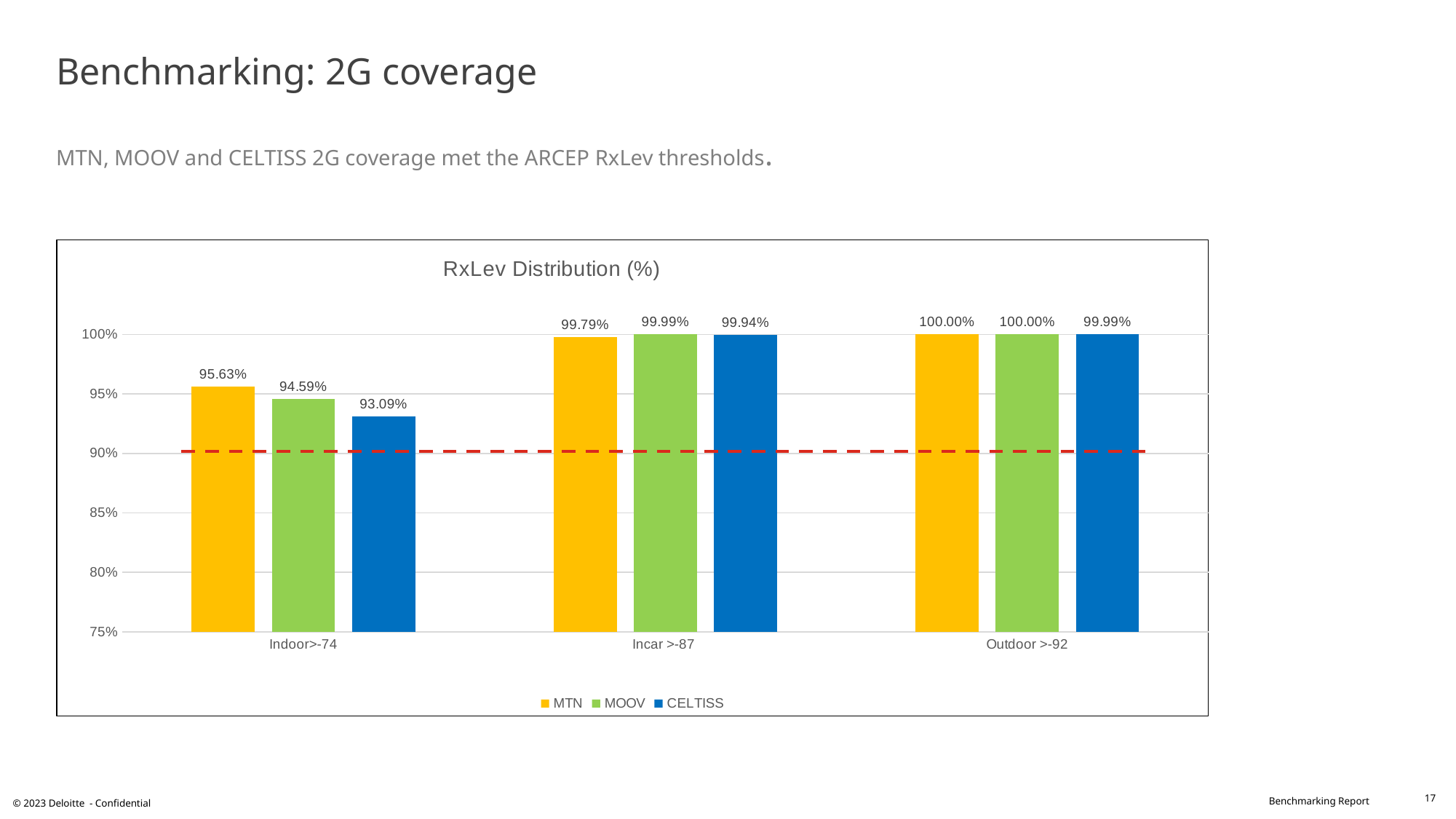
What is the value for MTN in the Indoor>-74 category? 95.63% What is the value for CELTISS in the Indoor>-74 category? 93.09% What kind of chart is shown on the slide? Bar chart Which is larger: MTN's value for Incar >-87 or MOOV's value for Incar >-87? MOOV's value for Incar >-87 How many categories are shown on the x axis? 3 What is the value for CELTISS in the Outdoor >-92 category? 99.99% What is the title of the chart? RxLev Distribution (%) What is the difference between MTN and CELTISS in the Indoor>-74 category? 2.54% How many series does the legend list? 3 Which operator has the lowest value in the Indoor>-74 category? CELTISS What is the value for MOOV in the Incar >-87 category? 99.99% Which operator has the highest value in the Indoor>-74 category? MTN